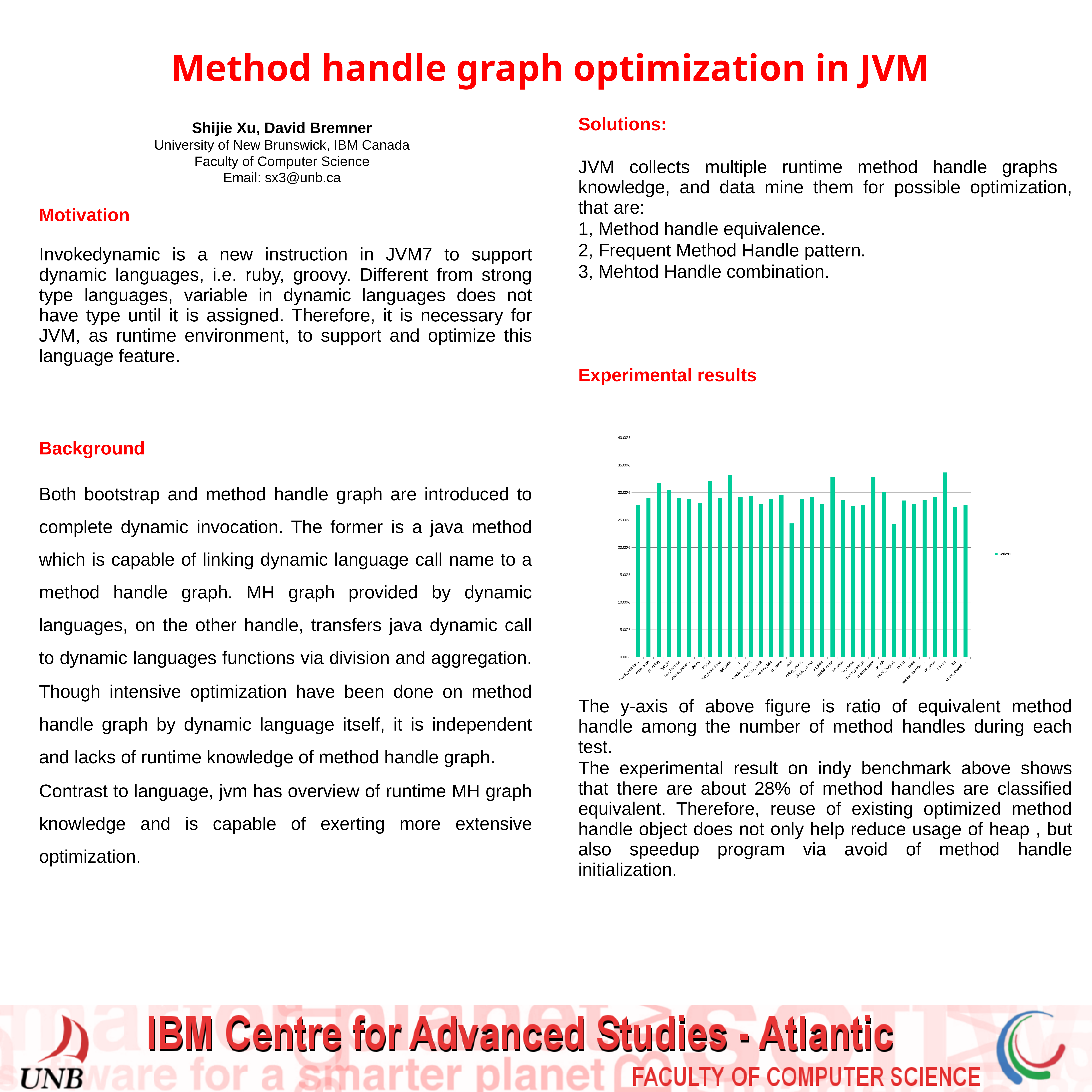
What is the highest value shown on the y-axis of the chart? 40.00% Is the value for gc_string greater or less than 30%? greater Is the value for partial_sums greater or less than 30%? greater Is the value for eval greater or less than 25%? less How many series does the legend of the chart list? 1 What is the name of the series shown in the chart legend? Series1 Which is larger, the value for primes or the value for eval? primes What kind of chart is shown under Experimental results? bar chart